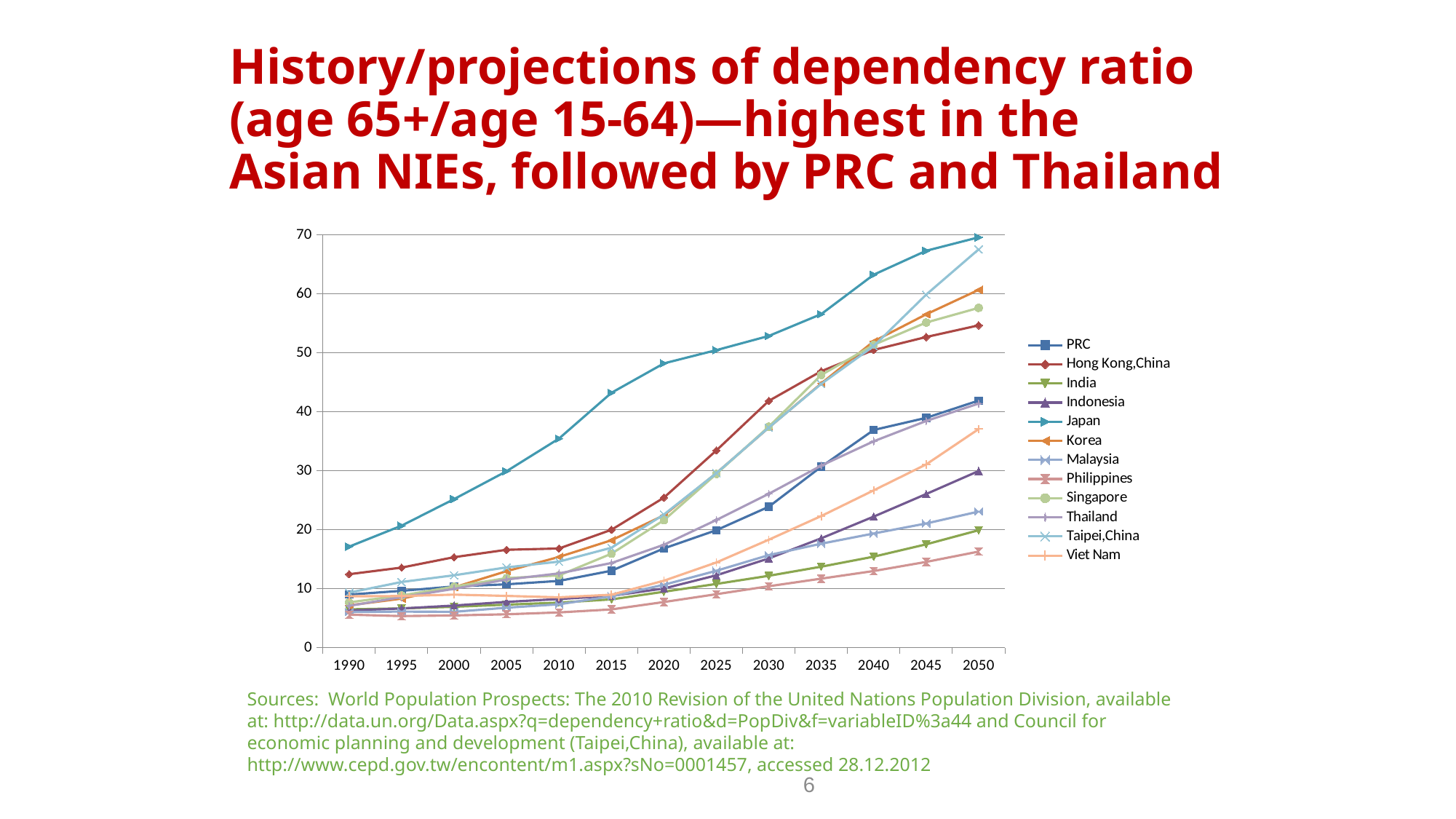
Is the value for Japan in 2050 greater or less than 60? greater In 2050, which is larger, the value for Indonesia or the value for Malaysia? Indonesia Which country has the lowest dependency ratio in 2050? Philippines Is the value for Japan in 2015 greater or less than 40? greater Does the dependency ratio for Japan rise or fall from 1990 to 2050? rise How many years are marked along the x axis? 13 What kind of chart is shown on the slide? line chart Is the value for Philippines in 2050 greater or less than 20? less What is the first entry listed in the legend? PRC Which country has the highest dependency ratio in 2050? Japan How many series does the legend list? 12